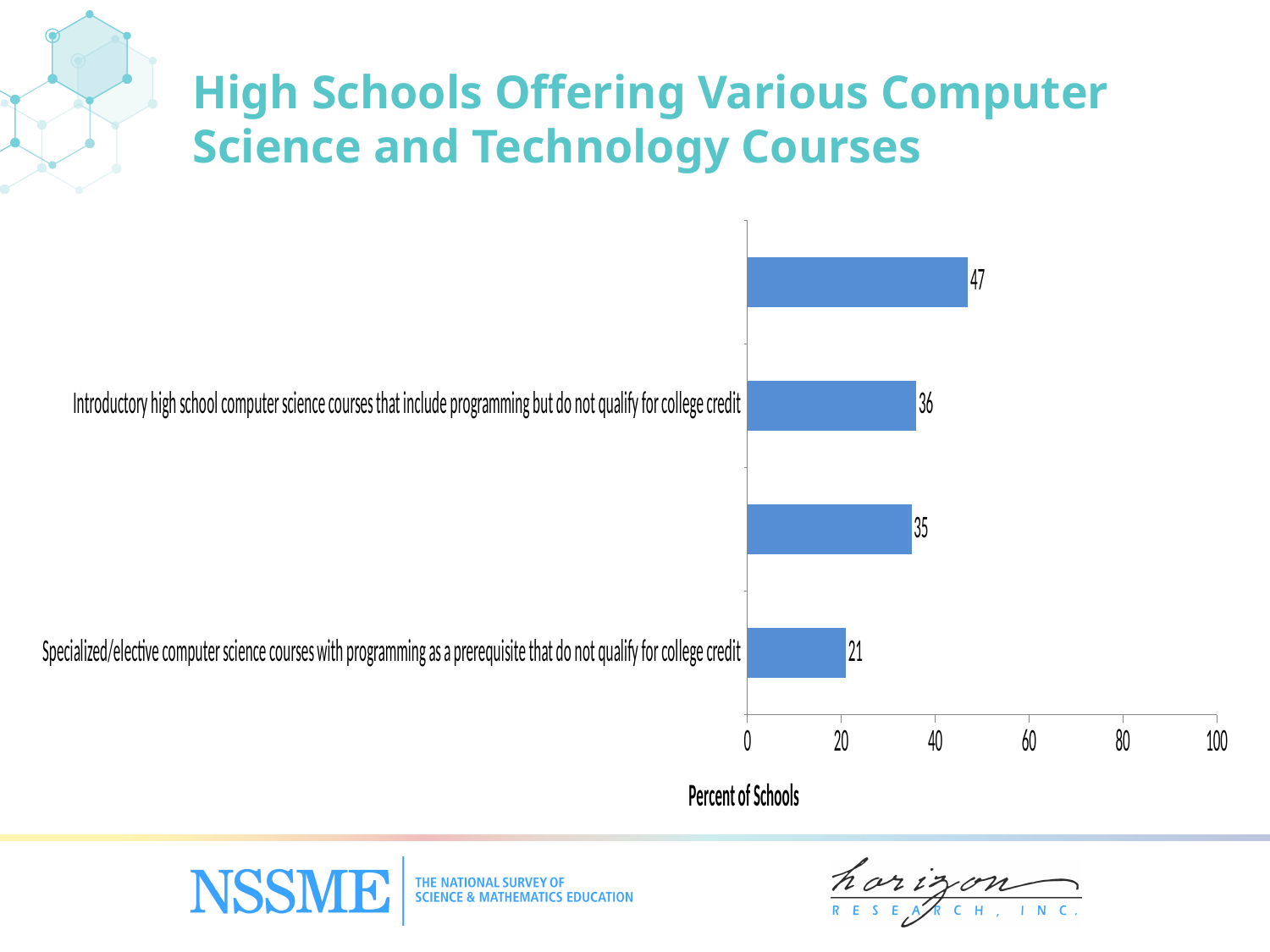
Is the highest bar on the chart greater or less than 40? greater What is the difference between the value for Introductory high school computer science courses that include programming but do not qualify for college credit and the value for Specialized/elective computer science courses with programming as a prerequisite that do not qualify for college credit? 15 What is the highest value shown on the chart? 47 What is the lowest value shown on the chart? 21 What kind of chart is shown on the slide? bar chart Is the value for Specialized/elective computer science courses with programming as a prerequisite that do not qualify for college credit greater or less than 40? less Which is larger: the value for Introductory high school computer science courses that include programming but do not qualify for college credit or the value for Specialized/elective computer science courses with programming as a prerequisite that do not qualify for college credit? Introductory high school computer science courses that include programming but do not qualify for college credit What is the value for Introductory high school computer science courses that include programming but do not qualify for college credit? 36 How many bars are plotted on the chart? 4 Which category has the lowest value on the chart? Specialized/elective computer science courses with programming as a prerequisite that do not qualify for college credit What is the value for Specialized/elective computer science courses with programming as a prerequisite that do not qualify for college credit? 21 What is the title of the horizontal axis? Percent of Schools